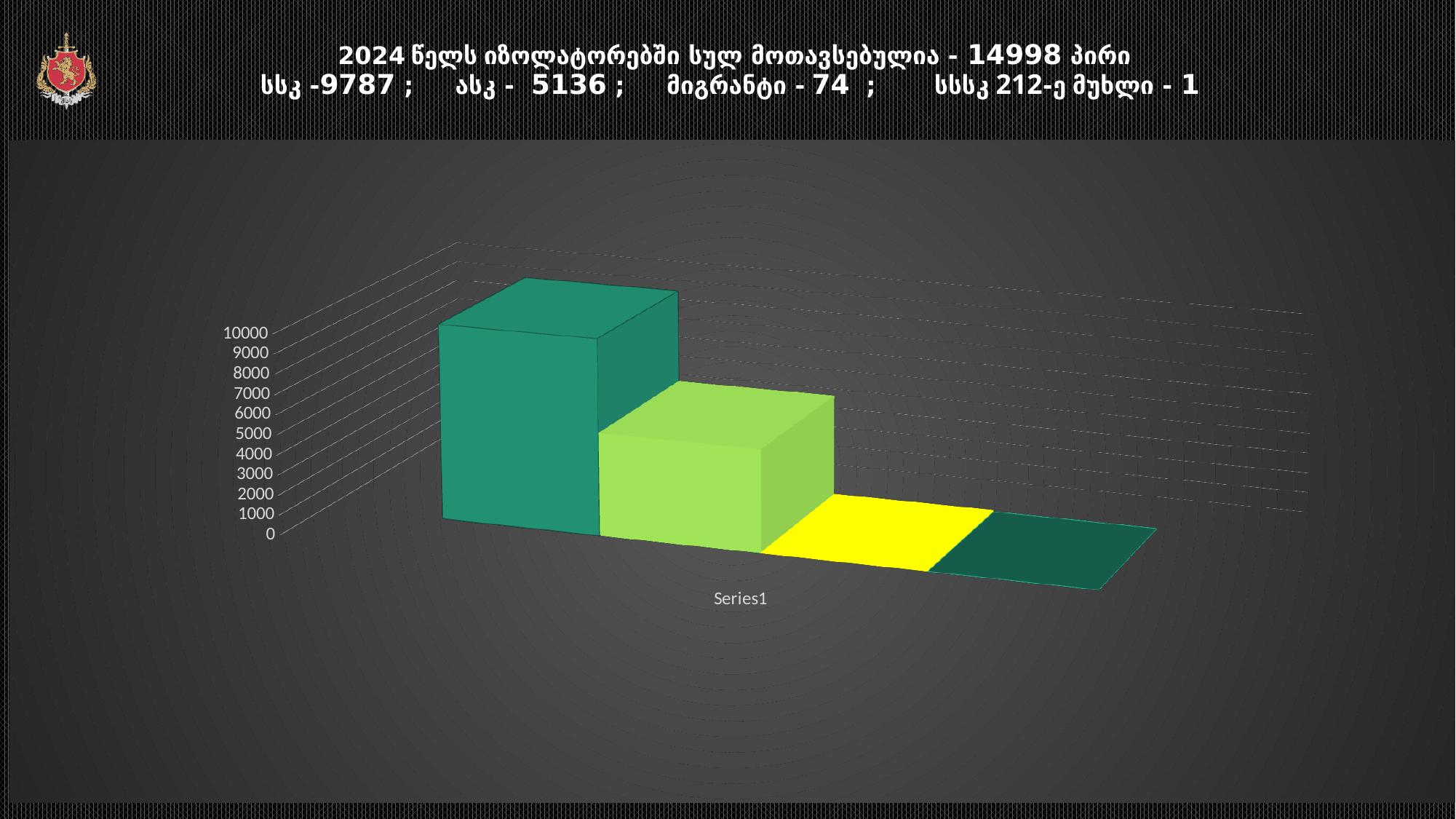
What label is shown under the bars on the horizontal axis? Series1 How many bars are plotted in the chart? 4 Do the bar values rise or fall from left to right along the x axis? fall Is the value of the leftmost bar greater or less than 9000? greater What is the highest tick value shown on the vertical axis? 10000 Is the value of the second bar from the left greater or less than 4000? greater Is the value of the second bar from the left greater or less than 6000? less Which bar in the chart is the highest? the first (leftmost) bar According to the slide heading, what is the total number of persons placed in isolators in 2024? 14998 What kind of chart is shown on the slide? bar chart Which is larger, the first bar or the second bar? the first bar